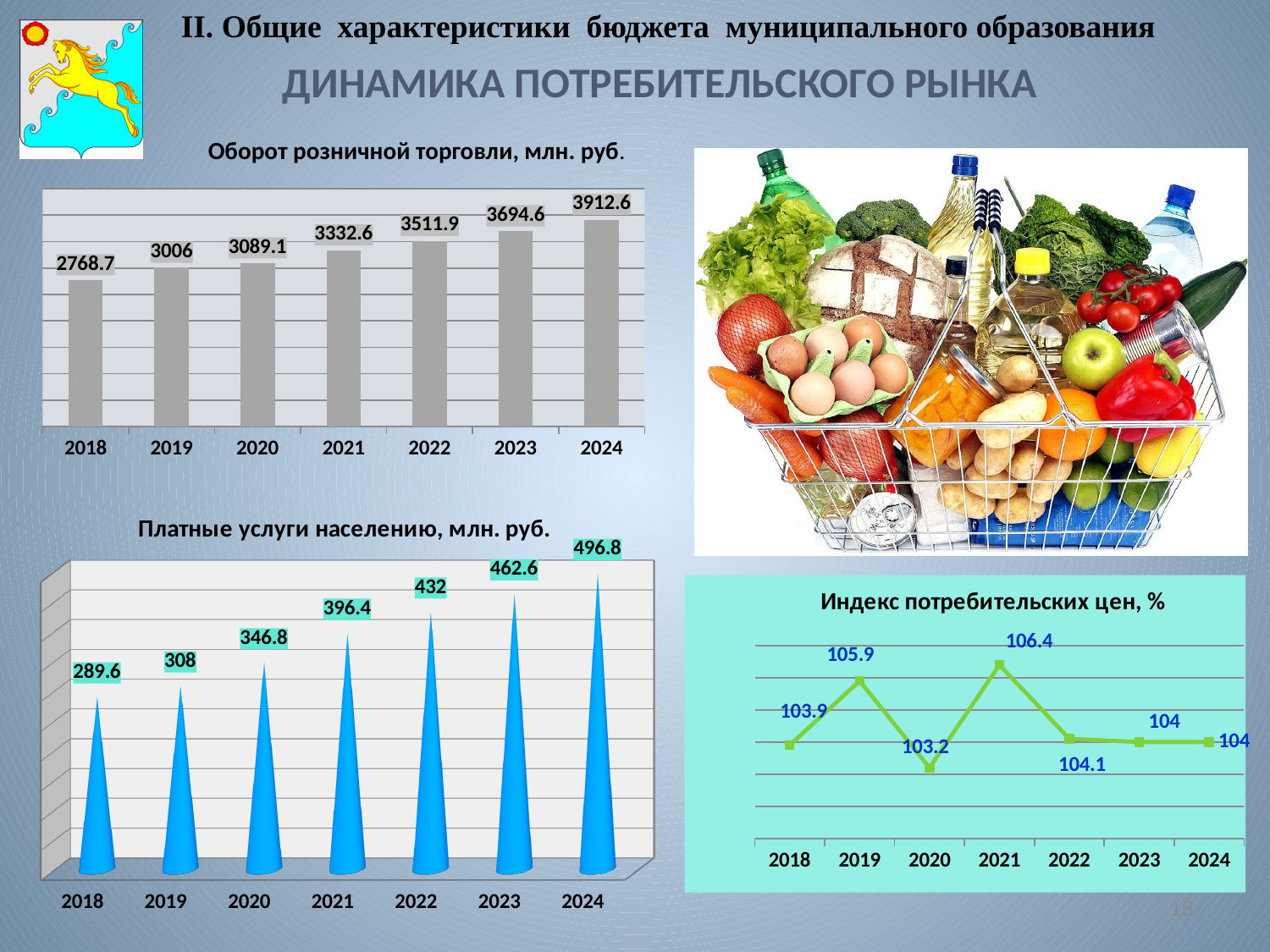
In the chart 'Оборот розничной торговли, млн. руб.', how many years are shown? 7 What kind of chart is 'Индекс потребительских цен, %'? line chart In the chart 'Оборот розничной торговли, млн. руб.', which year has the highest value? 2024 In the chart 'Оборот розничной торговли, млн. руб.', do the values rise or fall from 2018 to 2024? rise In the chart 'Платные услуги населению, млн. руб.', what is the difference between the 2023 and 2022 values? 30.6 In the chart 'Индекс потребительских цен, %', which year has the highest value? 2021 In the chart 'Индекс потребительских цен, %', which year has the lowest value? 2020 In the chart 'Платные услуги населению, млн. руб.', what is the value for 2020? 346.8 In the chart 'Платные услуги населению, млн. руб.', which year has the lowest value? 2018 In the chart 'Индекс потребительских цен, %', what is the value for 2019? 105.9 In the chart 'Оборот розничной торговли, млн. руб.', what is the value for 2021? 3332.6 In the chart 'Оборот розничной торговли, млн. руб.', what is the difference between the 2024 and 2018 values? 1143.9